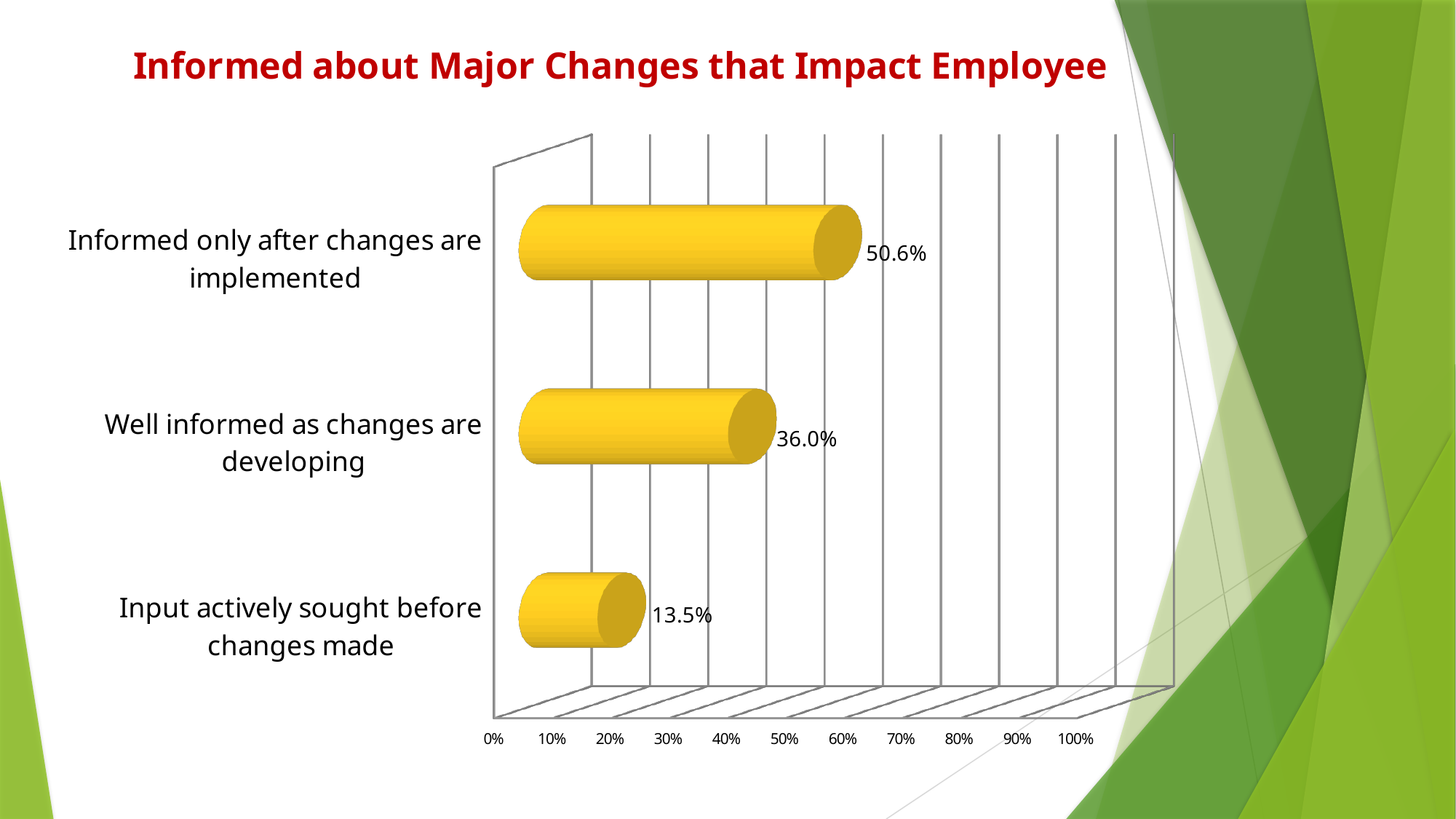
What kind of chart is shown on the slide? Bar chart What is the value for "Input actively sought before changes made"? 13.5% Which category has the lowest value? Input actively sought before changes made What is the difference between the values for "Well informed as changes are developing" and "Input actively sought before changes made"? 22.5% How many categories are shown in the chart? 3 Which category has the highest value? Informed only after changes are implemented What is the difference between the values for "Informed only after changes are implemented" and "Well informed as changes are developing"? 14.6% What is the title of the chart? Informed about Major Changes that Impact Employee Which is larger: the value for "Well informed as changes are developing" or the value for "Input actively sought before changes made"? Well informed as changes are developing What is the value for "Well informed as changes are developing"? 36.0% Is the value for "Informed only after changes are implemented" greater or less than 40%? greater What is the value for "Informed only after changes are implemented"? 50.6%